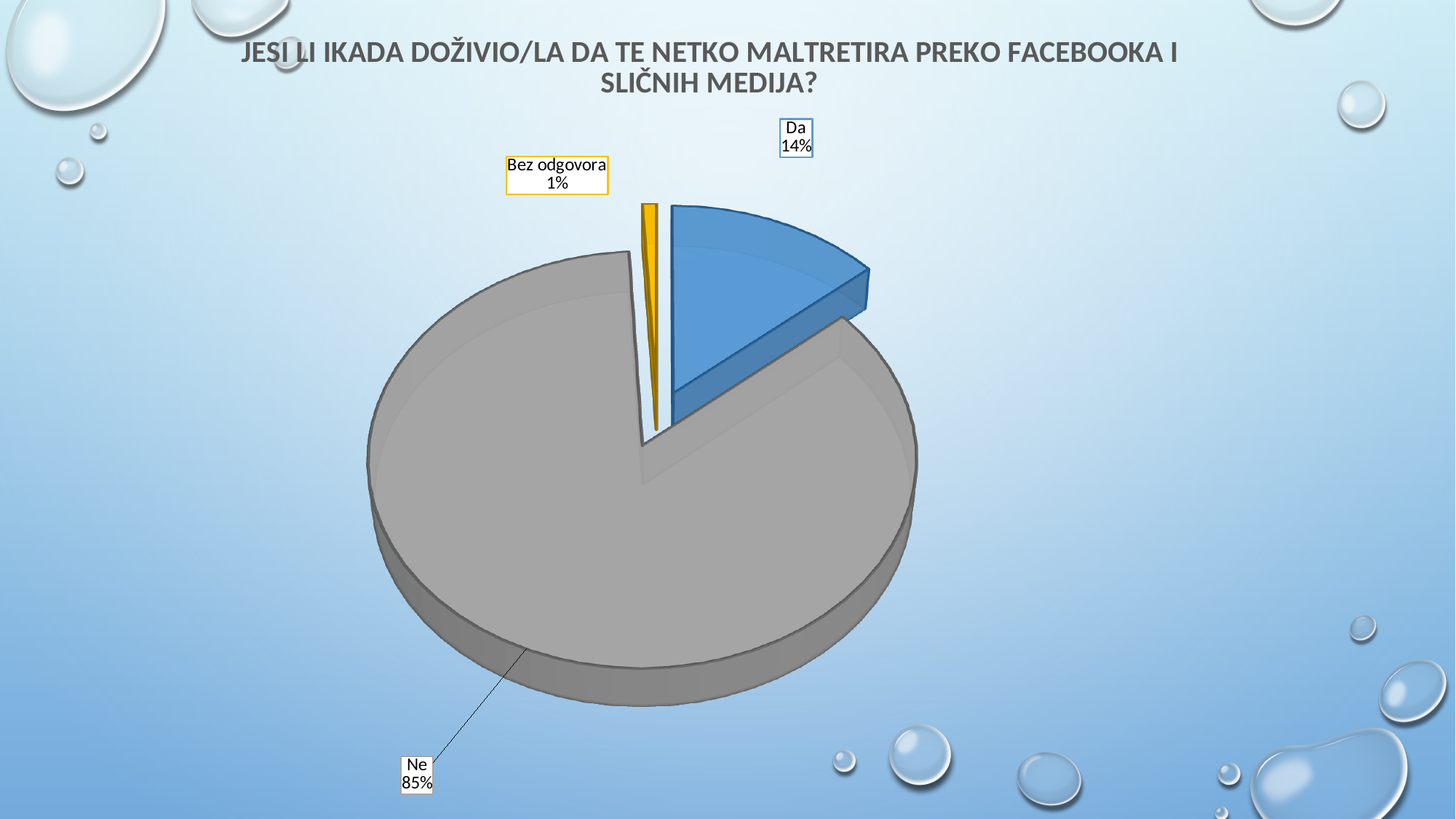
What colour is the slice for "Da"? Blue Which category has the smallest slice of the pie? Bez odgovora What is the difference in percentage points between "Ne" and "Da"? 71 Which is larger, the share for "Da" or the share for "Bez odgovora"? Da What is the title of the chart? Jesi li ikada doživio/la da te netko maltretira preko Facebooka i sličnih medija? What share of the pie does "Bez odgovora" represent? 1% What share of the pie does "Da" represent? 14% What share of the pie does "Ne" represent? 85% Which category has the largest slice of the pie? Ne How many categories are shown in the pie chart? 3 What kind of chart is shown on the slide? Pie chart What is the difference in percentage points between "Da" and "Bez odgovora"? 13